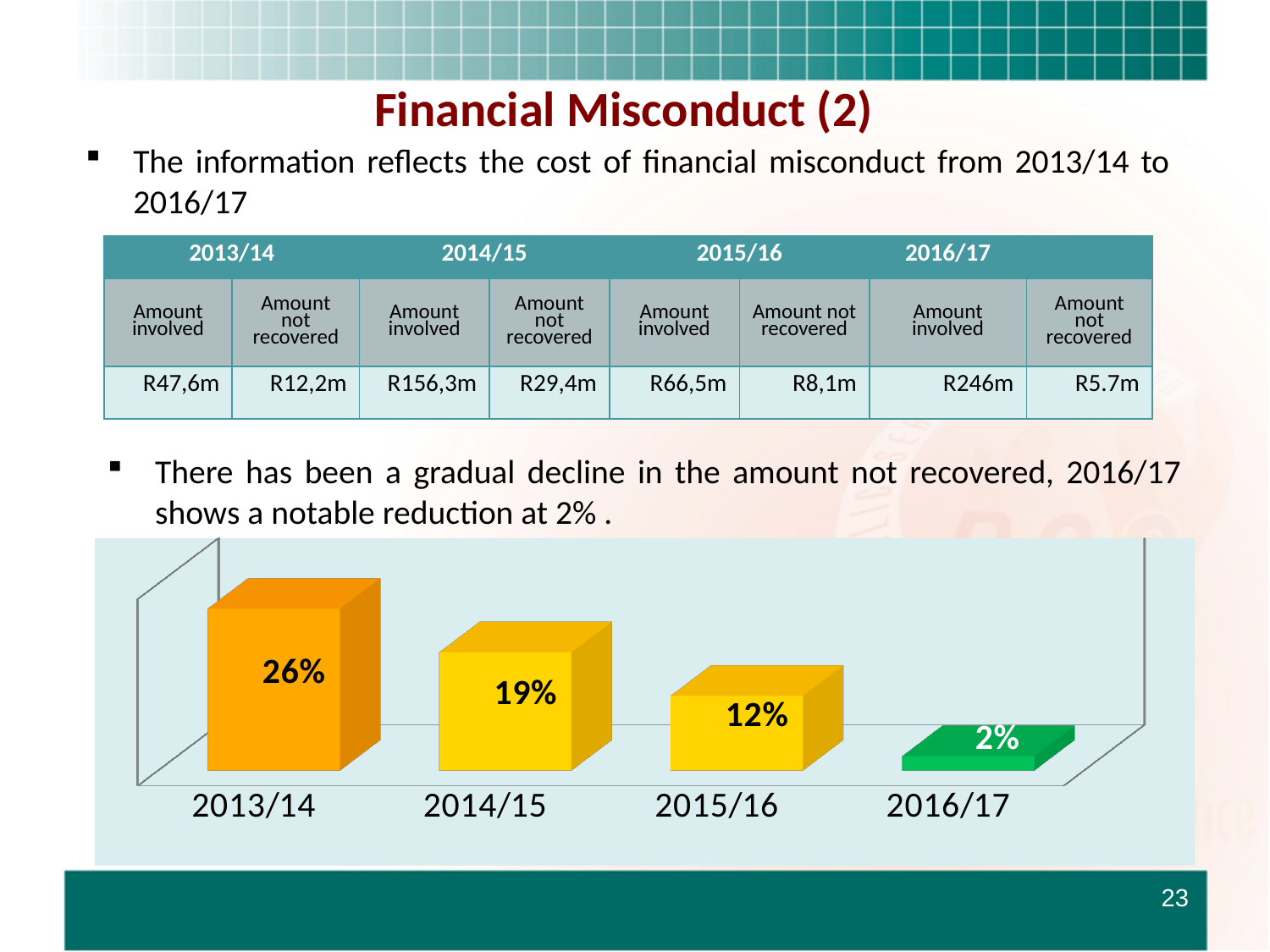
What kind of chart is shown on the slide? Bar chart What is the difference between the values for 2013/14 and 2016/17 in the bar chart? 24% Which is larger in the bar chart, the value for 2014/15 or the value for 2015/16? 2014/15 What value is shown for 2014/15 in the bar chart? 19% What value is shown for 2015/16 in the bar chart? 12% Which year has the highest value in the bar chart? 2013/14 Do the values in the bar chart rise or fall from 2013/14 to 2016/17? Fall Which year has the lowest value in the bar chart? 2016/17 What value is shown for 2016/17 in the bar chart? 2% How many years are shown in the bar chart? 4 What is the difference between the values for 2014/15 and 2015/16 in the bar chart? 7% What value is shown for 2013/14 in the bar chart? 26%